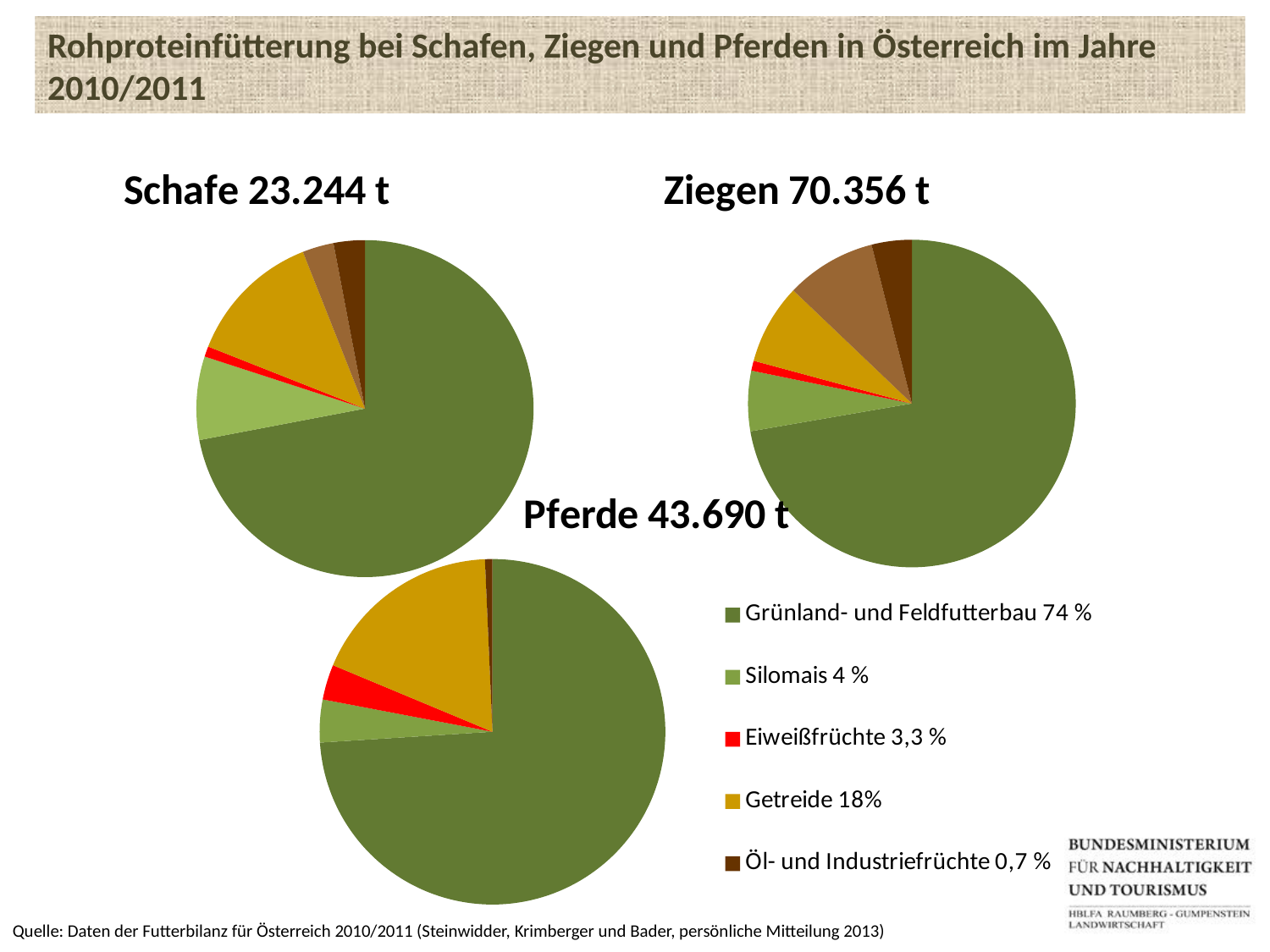
What is the difference between the total amounts shown for Ziegen and Schafe? 47.112 t According to the legend, what share is given for Grünland- und Feldfutterbau? 74 % In the Ziegen pie chart, which category has the largest slice? Grünland- und Feldfutterbau How many pie charts are shown on the slide? 3 How many entries does the legend list? 5 What total amount is given in the title of the Pferde pie chart? 43.690 t Which legend entry has the smallest percentage? Öl- und Industriefrüchte 0,7 % What kind of chart is used on this slide to show the Rohprotein feeding data? pie chart What total amount is given in the title of the Ziegen pie chart? 70.356 t According to the legend, what share is given for Getreide? 18% Which of the three animal groups has the largest total amount shown in its chart title? Ziegen What total amount is given in the title of the Schafe pie chart? 23.244 t